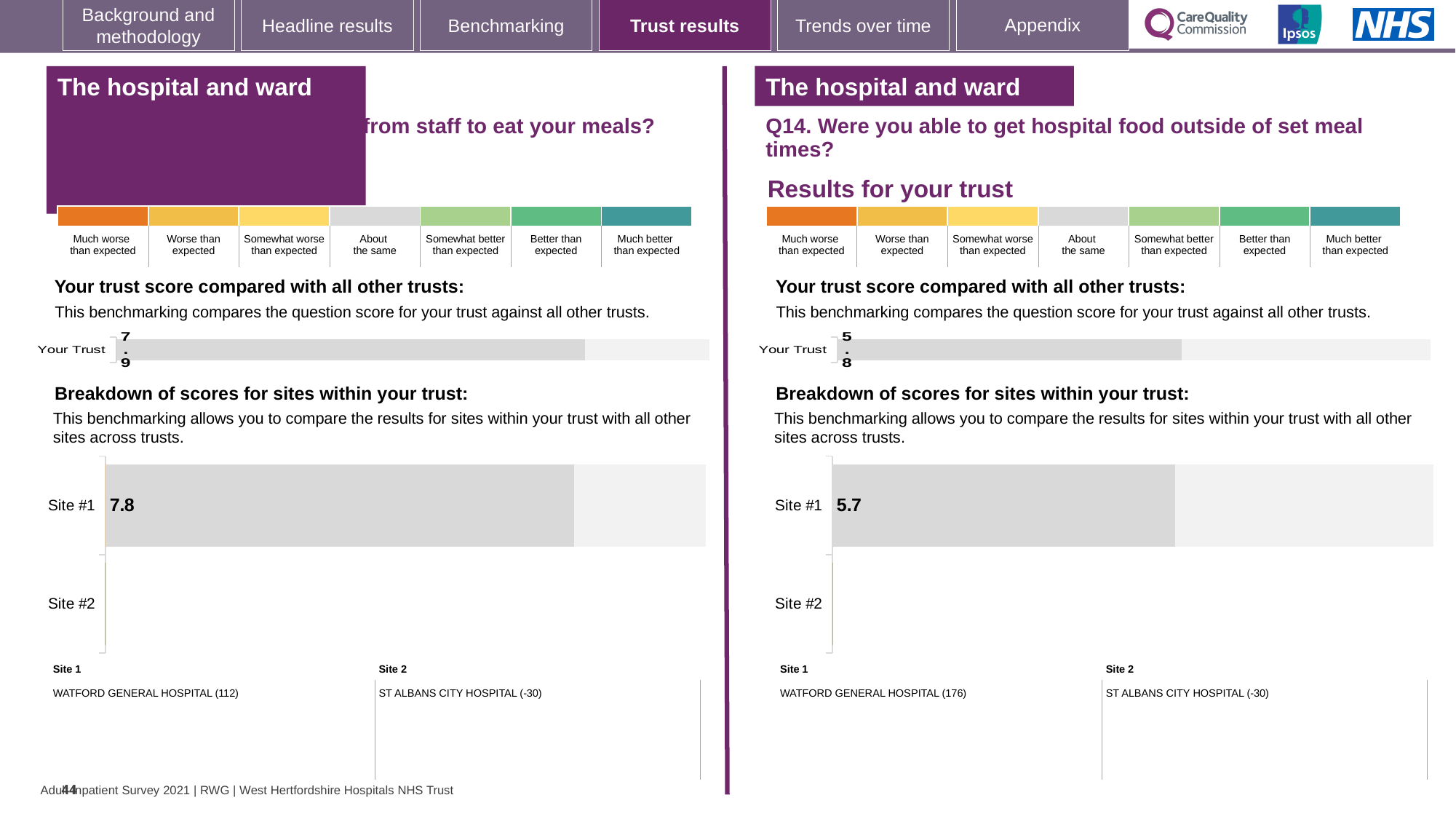
What kind of chart is used to show the Site #1 and Site #2 scores in the site breakdown sections? Bar chart What is the difference between the 'Your Trust' score on the left half of the slide (7.9) and the 'Your Trust' score on the right half (5.8)? 2.1 In the left-hand site breakdown chart, which site has a plotted bar with a score label? Site #1 According to the site key under the right-hand chart, which hospital is Site 1? WATFORD GENERAL HOSPITAL (176) Which is larger: the Site #1 score in the left-hand site breakdown chart or the Site #1 score in the right-hand site breakdown chart? Left-hand chart (7.8) Is the 'Your Trust' score on the right half of the slide (Q14) greater or less than the 'Your Trust' score on the left half? less What is the difference between the Site #1 score in the left-hand site breakdown chart (7.8) and the Site #1 score in the right-hand site breakdown chart (5.7)? 2.1 On the right half of the slide (Q14), what is the 'Your Trust' score shown in the trust score bar chart? 5.8 In the left-hand 'Breakdown of scores for sites within your trust' chart, what is the score for Site #1? 7.8 On the left half of the slide, what is the 'Your Trust' score shown in the trust score bar chart? 7.9 In the right-hand 'Breakdown of scores for sites within your trust' chart (Q14), what is the score for Site #1? 5.7 How many sites are listed as categories in the right-hand 'Breakdown of scores for sites within your trust' chart? 2